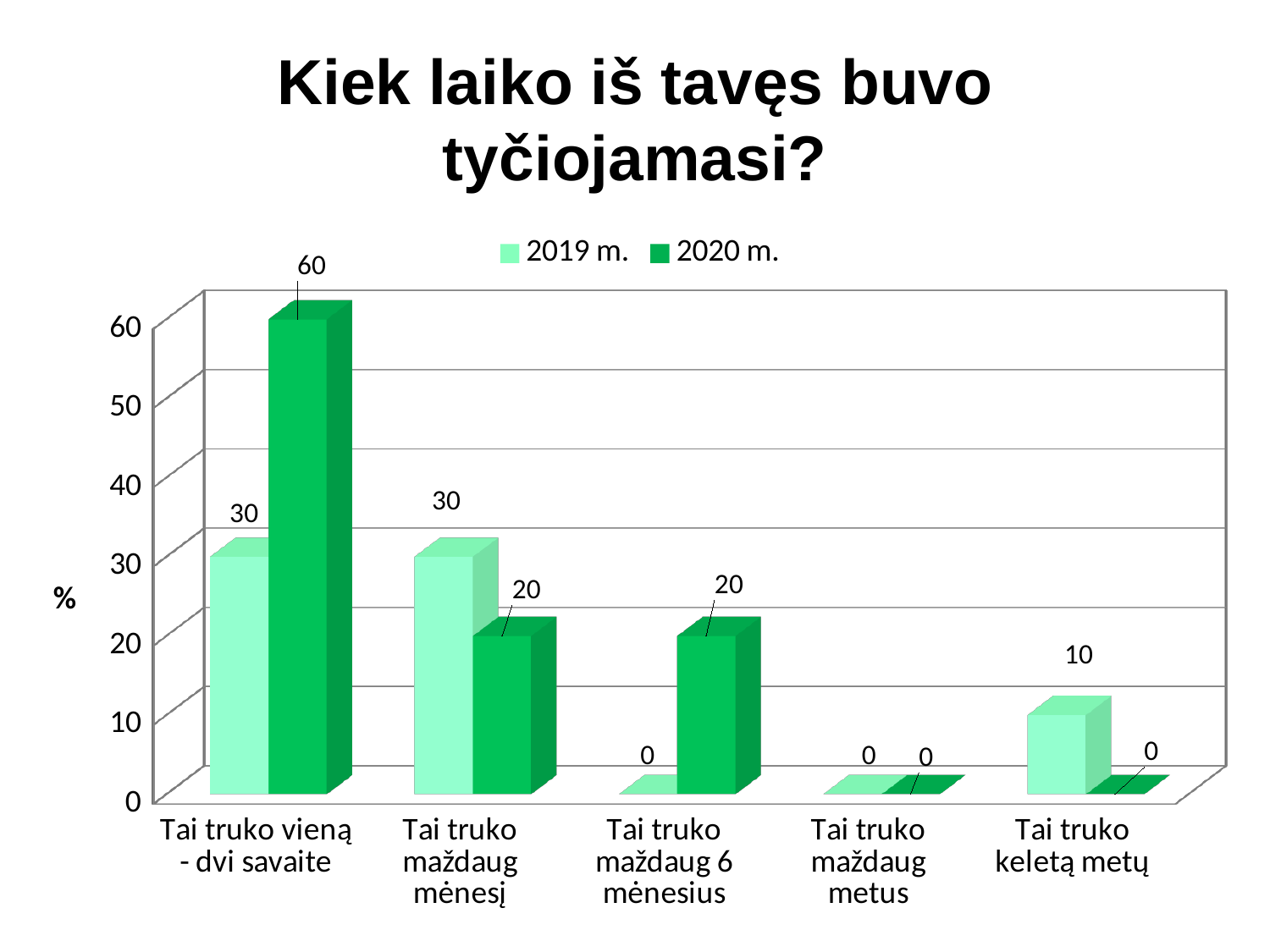
What is the value for 2019 m. in the category "Tai truko maždaug mėnesį"? 30 What is the value for 2020 m. in the category "Tai truko maždaug 6 mėnesius"? 20 What kind of chart is shown on the slide? Bar chart What is the value for 2019 m. in the category "Tai truko keletą metų"? 10 In the category "Tai truko maždaug mėnesį", which series has the larger value, 2019 m. or 2020 m.? 2019 m. How many series does the legend list? 2 What is the difference between the 2019 m. values for "Tai truko maždaug mėnesį" and "Tai truko keletą metų"? 20 How many categories are shown on the x axis? 5 What is the difference between the 2020 m. and 2019 m. values in the category "Tai truko vieną - dvi savaite"? 30 What is the title of the chart? Kiek laiko iš tavęs buvo tyčiojamasi? What is the value for 2020 m. in the category "Tai truko vieną - dvi savaite"? 60 Which category has the highest value for 2020 m.? Tai truko vieną - dvi savaite